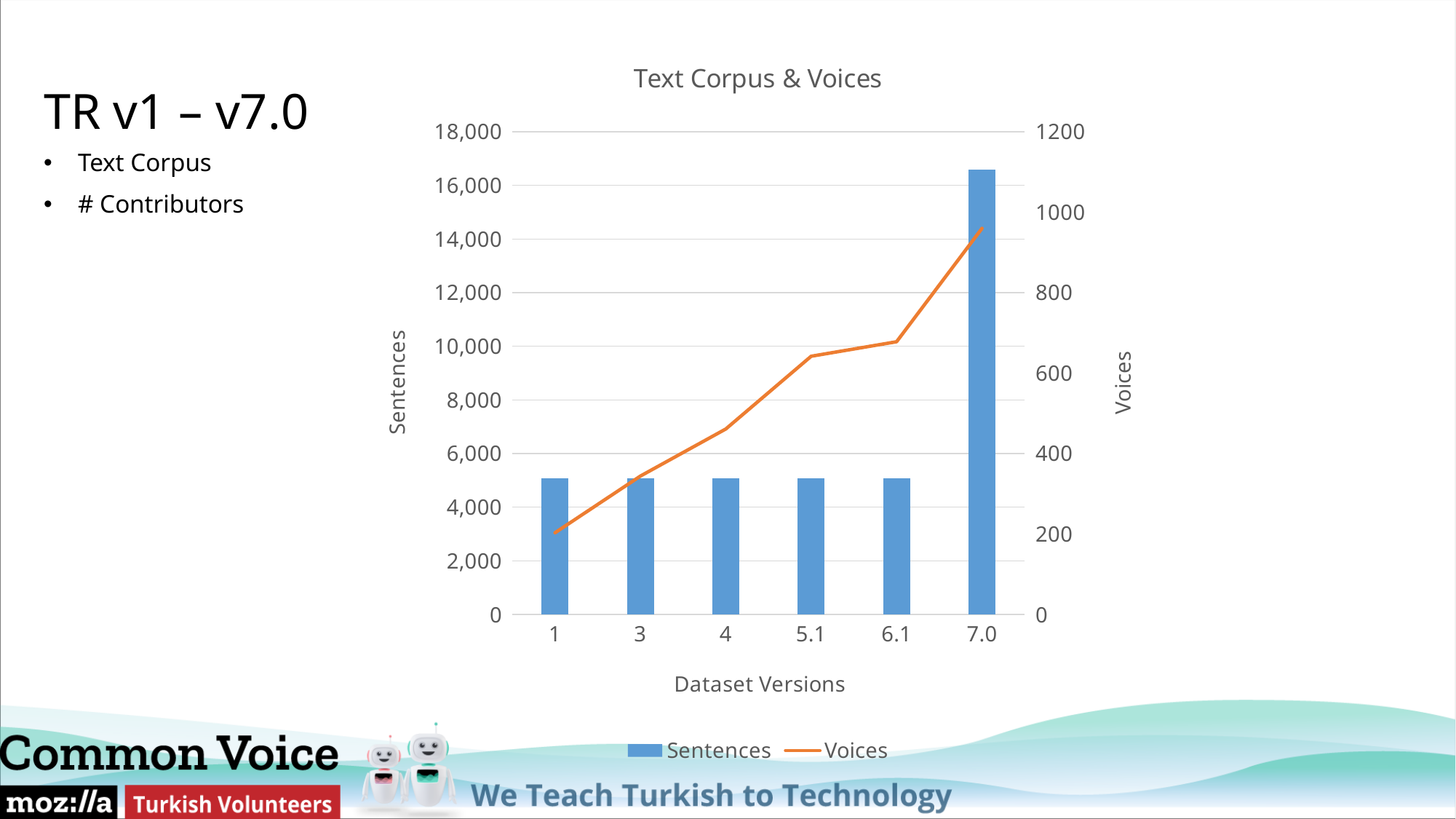
How many dataset versions are shown on the x axis of the chart? 6 Do the Voices values rise or fall from version 1 to version 7.0? rise Is the number of Sentences for version 7.0 greater or less than 16,000? greater Is the number of Voices for version 5.1 greater or less than 600? greater Which dataset version has the highest number of Voices? 7.0 Which dataset version has the lowest number of Voices? 1 How many series does the chart legend list? 2 What is the title of the chart? Text Corpus & Voices Is the number of Sentences for version 3 greater or less than 6,000? less Which dataset version has the highest number of Sentences? 7.0 Which series is plotted as a line in the chart? Voices